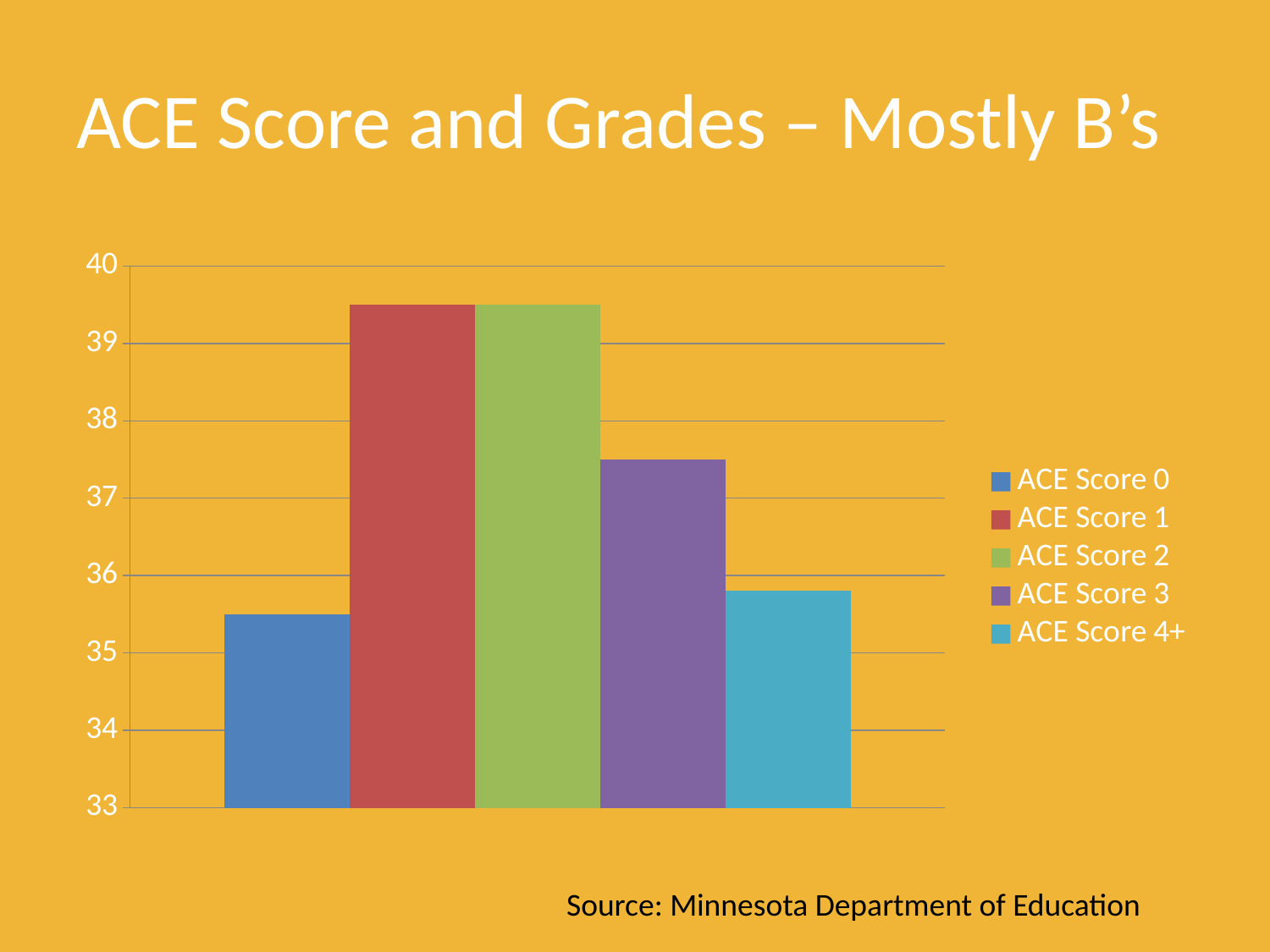
Is the value for ACE Score 4+ greater or less than 37? less How many bars are plotted in the chart? 5 Is the value for ACE Score 0 greater or less than 36? less Which is larger, the value for ACE Score 1 or the value for ACE Score 3? ACE Score 1 Is the value for ACE Score 3 greater or less than 37? greater How many series does the legend list? 5 What is the title of the slide? ACE Score and Grades – Mostly B's What kind of chart is shown on the slide? bar chart Which is larger, the value for ACE Score 3 or the value for ACE Score 4+? ACE Score 3 What colour is the bar for ACE Score 2? green